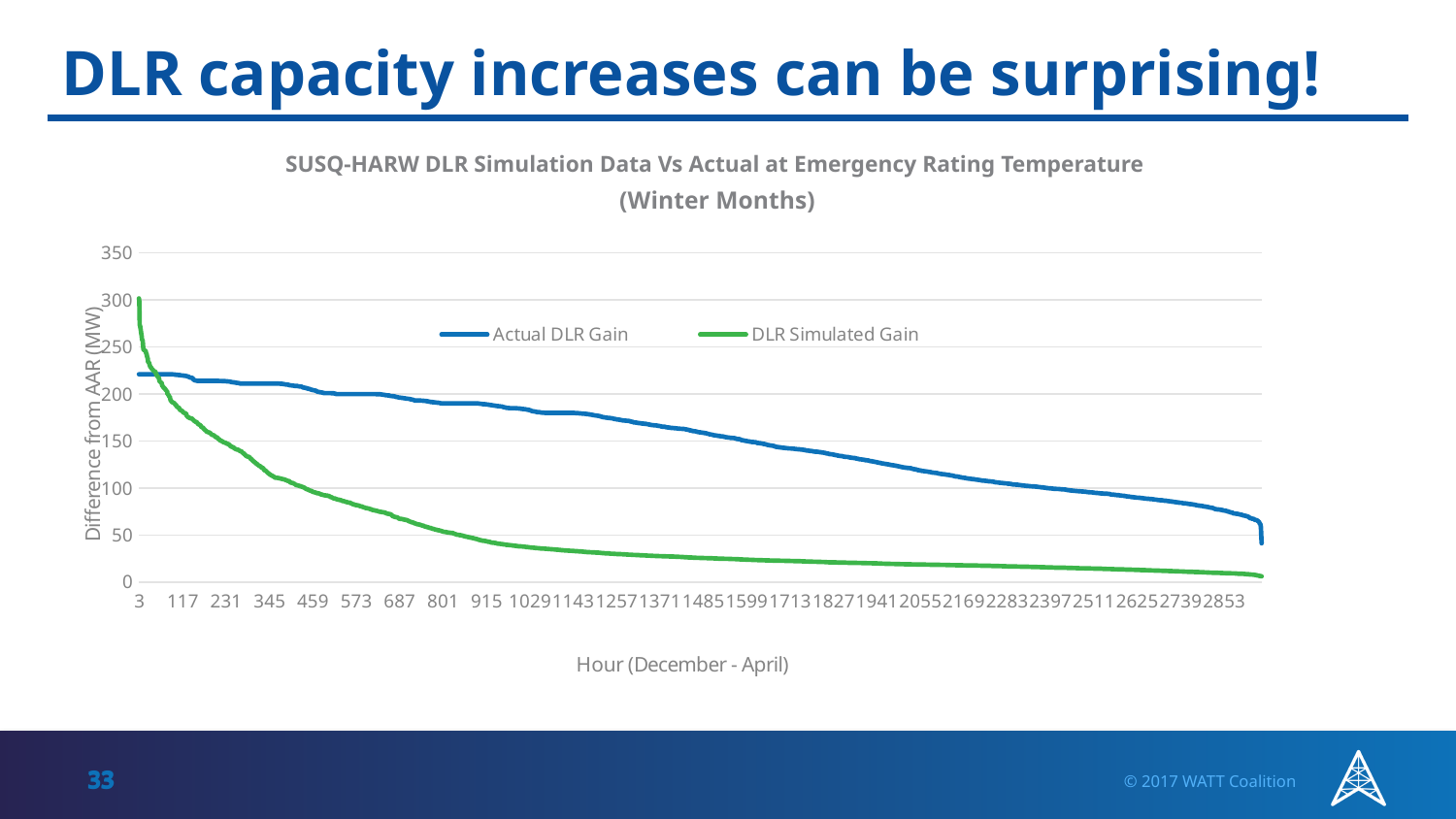
Is the value for DLR Simulated Gain at hour 2853 greater or less than 50? less Is the value for DLR Simulated Gain at hour 1029 greater or less than 50? less Do the values of the Actual DLR Gain series rise or fall along the x axis? Fall How many series does the legend list? 2 What is the title of the chart? SUSQ-HARW DLR Simulation Data Vs Actual at Emergency Rating Temperature (Winter Months) What kind of chart is shown on the slide? Line chart At hour 3, which series has the larger value, Actual DLR Gain or DLR Simulated Gain? DLR Simulated Gain At hour 1029, which series has the larger value, Actual DLR Gain or DLR Simulated Gain? Actual DLR Gain Is the value for Actual DLR Gain at hour 3 greater or less than 200? greater Do the values of the DLR Simulated Gain series rise or fall along the x axis? Fall What are the two series named in the legend? Actual DLR Gain and DLR Simulated Gain